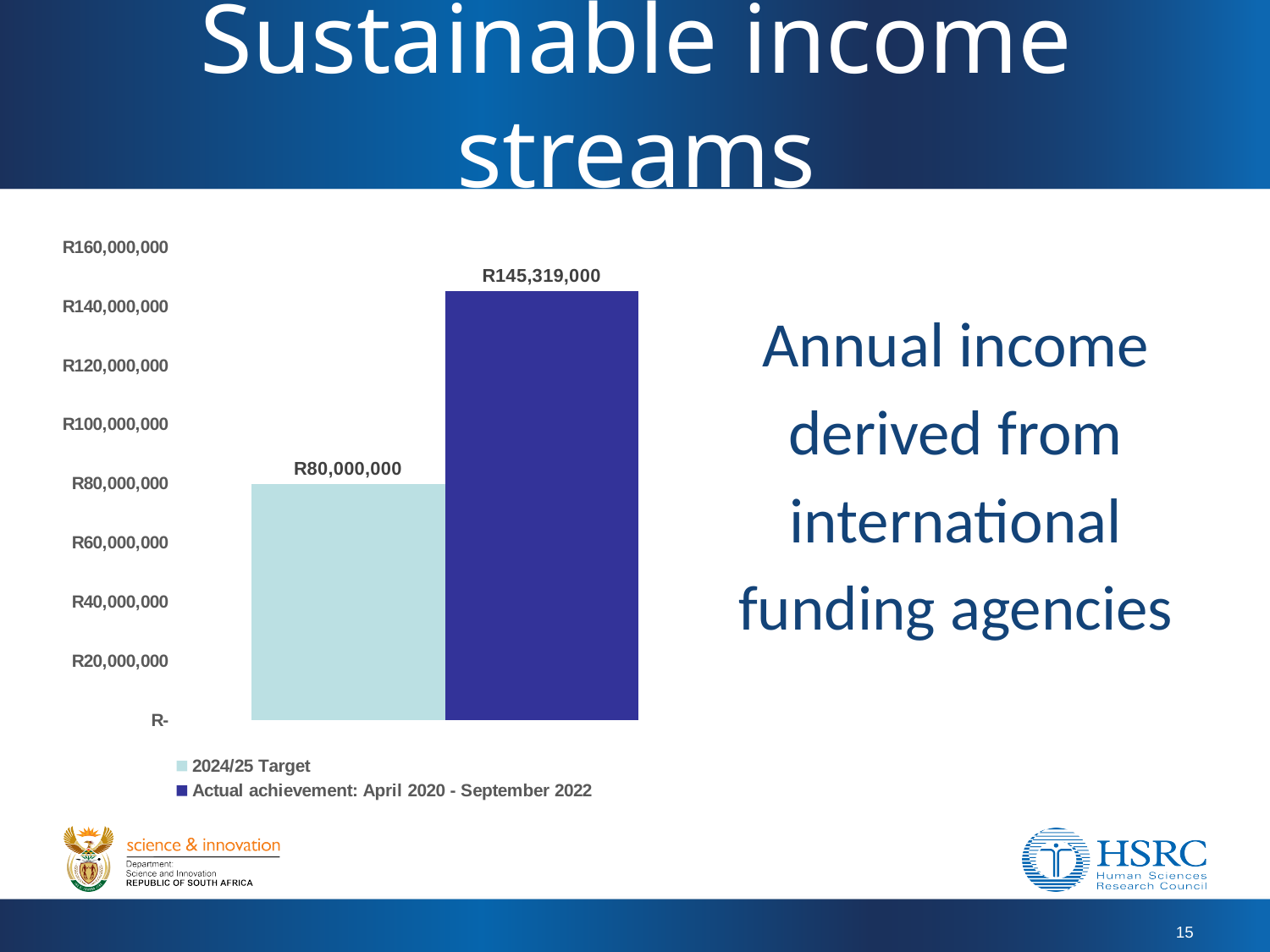
What is the difference between the Actual achievement and the 2024/25 Target? R65,319,000 What is the highest value shown on the vertical axis? R160,000,000 Is the value for 2024/25 Target greater or less than R100,000,000? less How many series does the legend list? 2 What kind of chart is shown on the slide? bar chart What is the value of the 2024/25 Target bar? R80,000,000 Which series has the higher value, 2024/25 Target or Actual achievement: April 2020 - September 2022? Actual achievement: April 2020 - September 2022 Which series has the lower value? 2024/25 Target What is the value of the Actual achievement: April 2020 - September 2022 bar? R145,319,000 Is the value for Actual achievement: April 2020 - September 2022 greater or less than R140,000,000? greater Is the Actual achievement value larger or smaller than the 2024/25 Target value? larger How many bars are plotted in the chart? 2